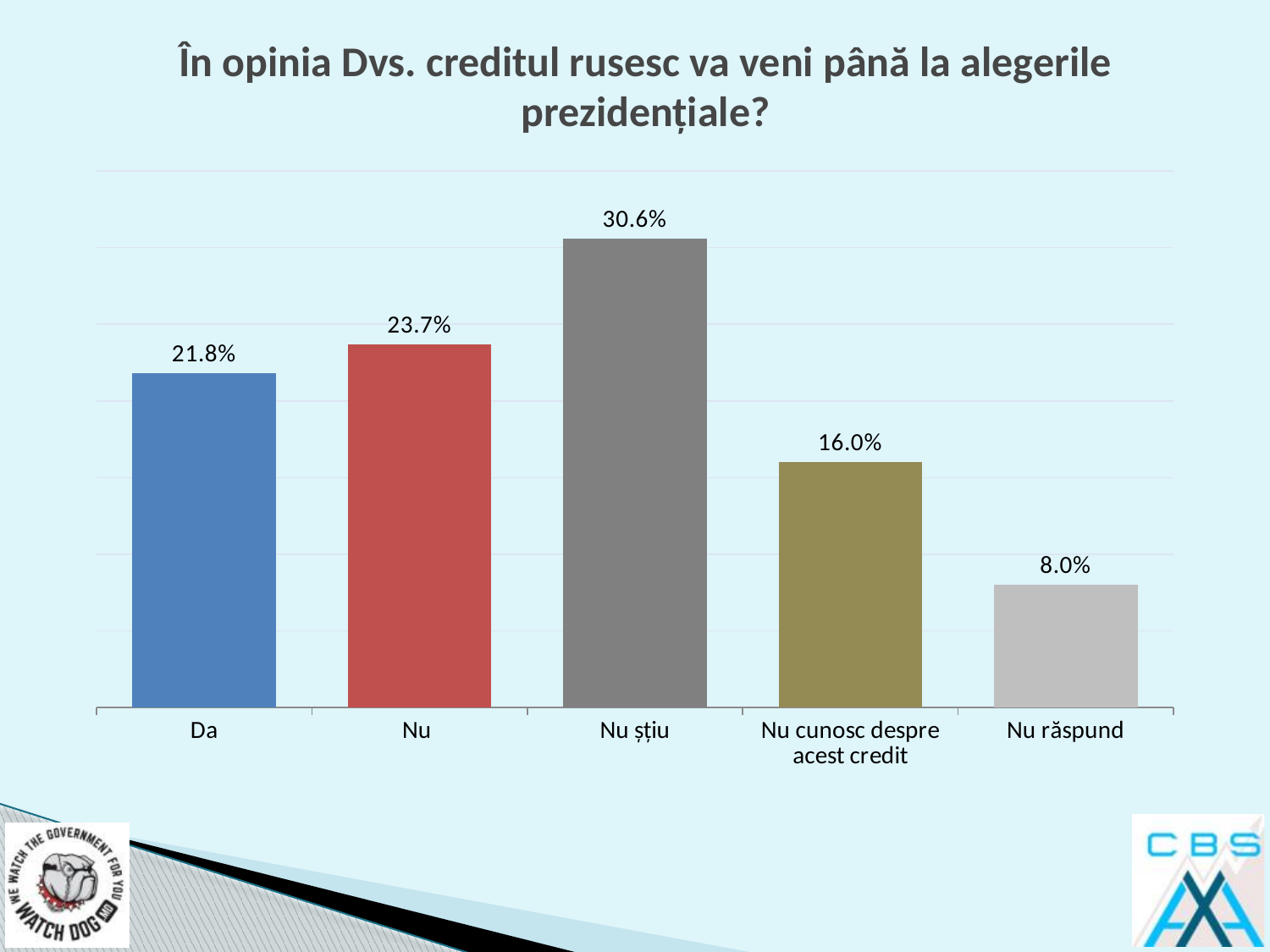
What is the value for "Nu știu"? 30.6% What kind of chart is shown on the slide? Bar chart Which category has the lowest value? Nu răspund Which category has the highest value? Nu știu What is the difference between the values for "Nu știu" and "Da"? 8.8% What is the value for "Nu răspund"? 8.0% What is the value for "Nu cunosc despre acest credit"? 16.0% What is the title of the chart? În opinia Dvs. creditul rusesc va veni până la alegerile prezidențiale? What is the value for "Da"? 21.8% Which is larger, the value for "Nu" or the value for "Da"? Nu How many categories are shown in the chart? 5 What is the value for "Nu"? 23.7%